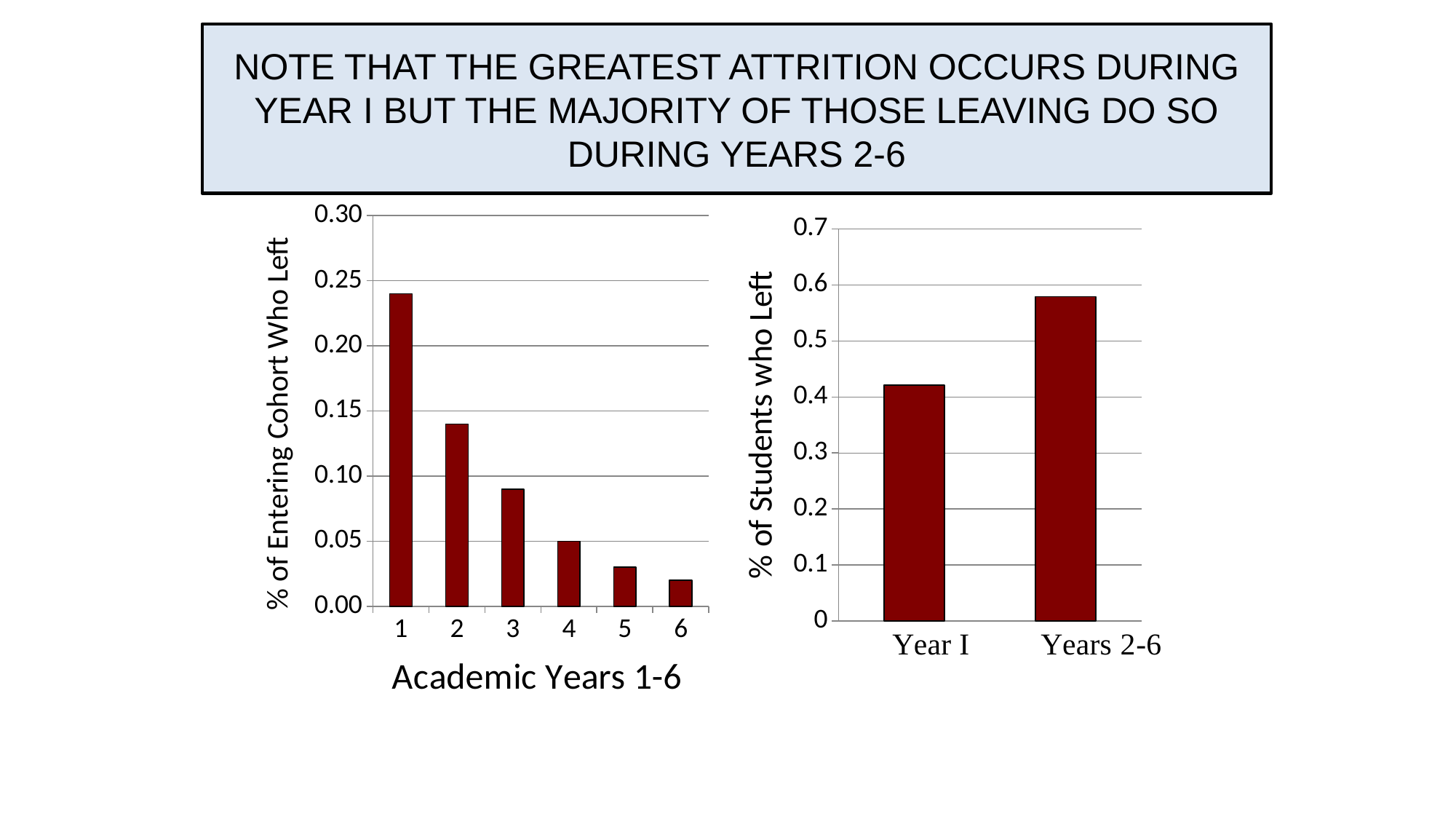
How many academic years are plotted on the left chart (Academic Years 1-6)? 6 On the left chart (Academic Years 1-6), do the values rise or fall from year 1 to year 6? fall On the left chart (Academic Years 1-6), which academic year has the highest % of entering cohort who left? 1 On the right chart (% of Students who Left), is the value for Years 2-6 greater or less than 0.5? greater What is the x-axis title of the left chart? Academic Years 1-6 On the left chart (Academic Years 1-6), which academic year has the lowest % of entering cohort who left? 6 On the left chart (Academic Years 1-6), which is larger, the value for year 2 or the value for year 3? year 2 What kind of chart is the left chart (Academic Years 1-6)? bar chart On the left chart (Academic Years 1-6), is the value for year 1 greater or less than 0.20? greater On the right chart (% of Students who Left), is the value for Year I greater or less than 0.5? less On the right chart (% of Students who Left), which category has the higher value, Year I or Years 2-6? Years 2-6